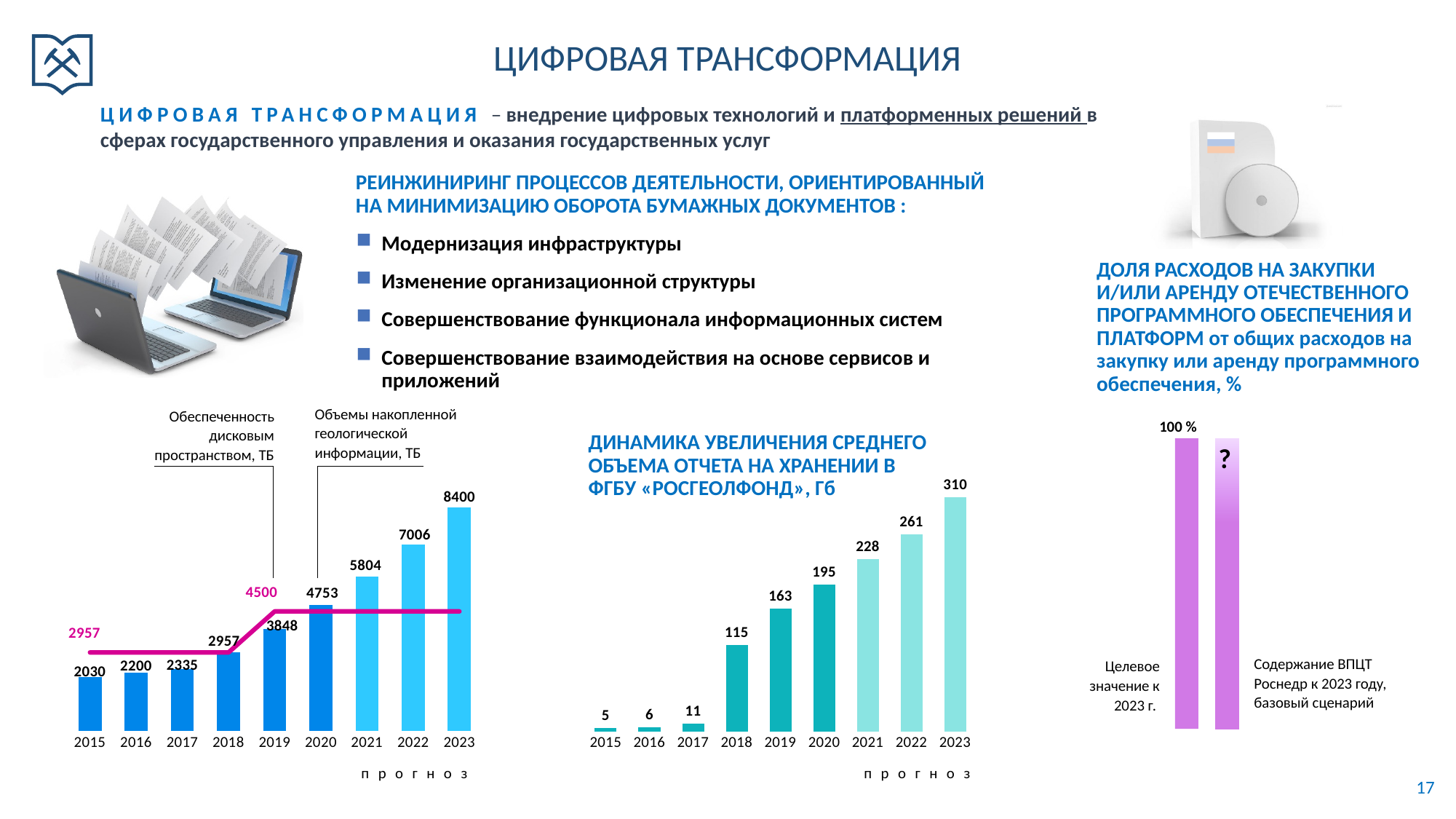
In the chart titled «ДИНАМИКА УВЕЛИЧЕНИЯ СРЕДНЕГО ОБЪЕМА ОТЧЕТА НА ХРАНЕНИИ В ФГБУ «РОСГЕОЛФОНД», Гб», what is the value for 2020? 195 In the left chart (Объемы накопленной геологической информации, ТБ), what is the difference between the bar values for 2023 and 2022? 1394 In the left chart (Объемы накопленной геологической информации, ТБ), which year has the larger bar value, 2019 or 2020? 2020 In the middle chart (average report volume in Гб), do the values rise or fall from 2015 to 2023? rise In the left chart (Объемы накопленной геологической информации, ТБ), which year has the lowest bar value? 2015 How many years are shown on the x axis of the middle chart (average report volume in Гб)? 9 In the left chart (Объемы накопленной геологической информации, ТБ), what is the bar value for 2021? 5804 In the left chart, what is the value of the line «Обеспеченность дисковым пространством, ТБ» for 2019? 4500 What kind of chart is the middle chart (ДИНАМИКА УВЕЛИЧЕНИЯ СРЕДНЕГО ОБЪЕМА ОТЧЕТА)? bar chart In the right chart (ДОЛЯ РАСХОДОВ НА ЗАКУПКИ И/ИЛИ АРЕНДУ ОТЕЧЕСТВЕННОГО ПРОГРАММНОГО ОБЕСПЕЧЕНИЯ), what is the value labelled for «Целевое значение к 2023 г.»? 100 % In the middle chart (average report volume in Гб), which year has the highest value? 2023 In the middle chart (average report volume in Гб), what is the difference between the values for 2023 and 2022? 49